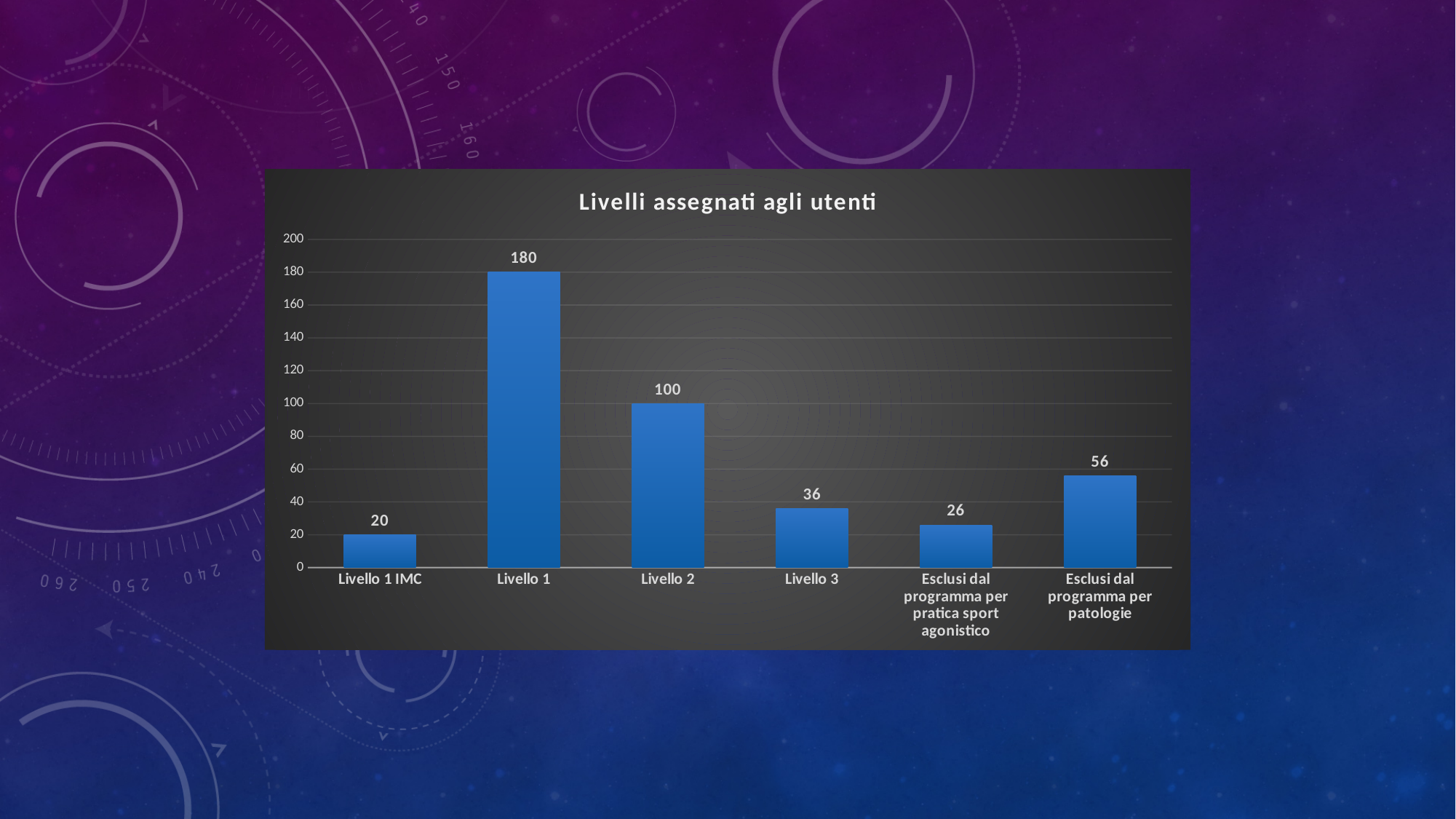
What is the value for Livello 1 IMC? 20 What is the value for Esclusi dal programma per patologie? 56 What is the difference between the values for Livello 1 and Livello 2? 80 Which is larger, the value for Livello 3 or the value for Esclusi dal programma per pratica sport agonistico? Livello 3 What is the value for Livello 1? 180 Which category has the highest value? Livello 1 What kind of chart is shown on the slide? bar chart Is the value for Esclusi dal programma per patologie greater or less than 40? greater What is the title of the chart? Livelli assegnati agli utenti Which category has the lowest value? Livello 1 IMC What is the value for Livello 2? 100 How many categories are shown on the x axis? 6